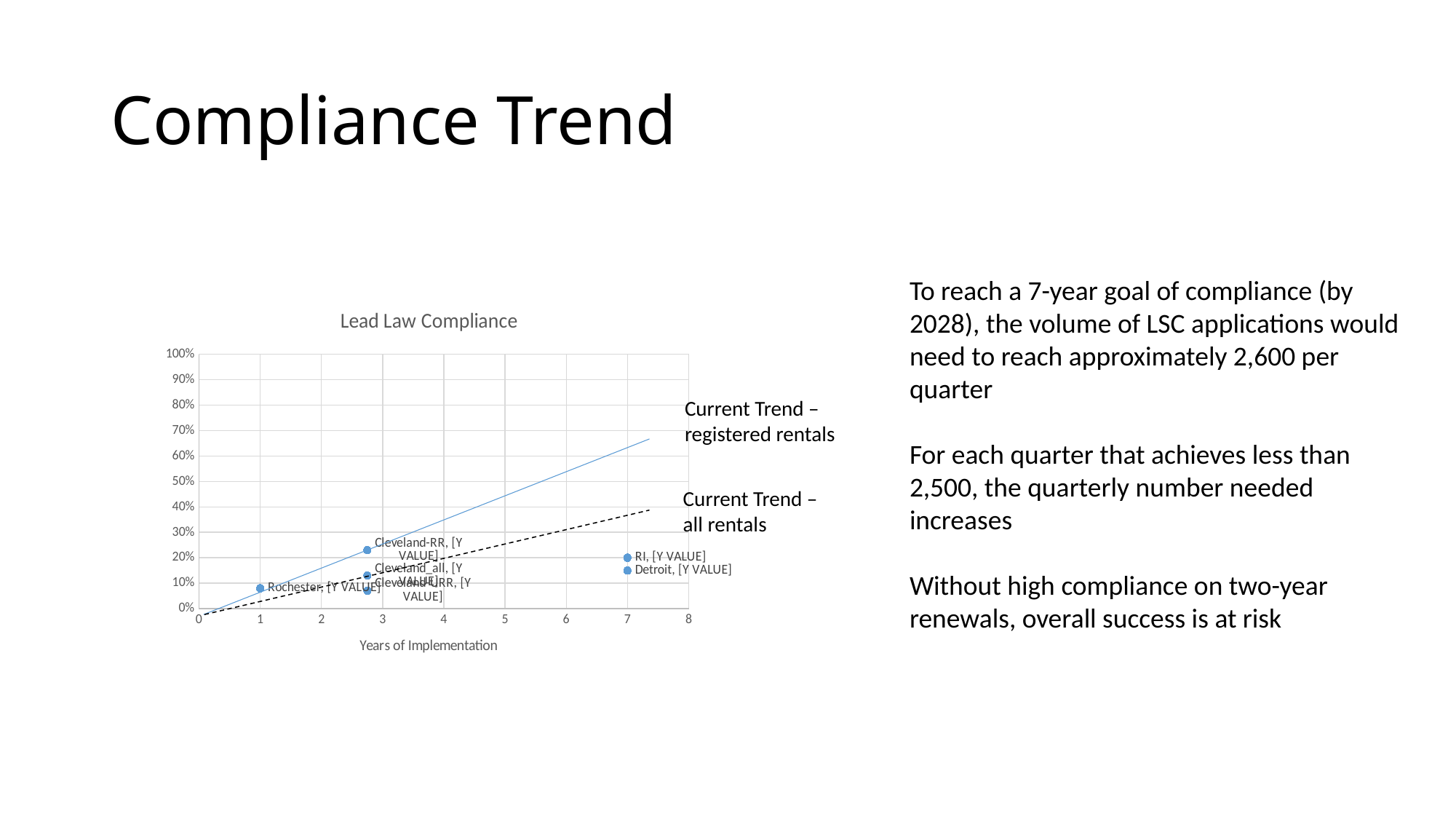
Which trend line is higher at 7 years of implementation, the registered rentals trend or the all rentals trend? registered rentals How many labelled data points are plotted on the chart? 6 Which is larger, the value for Cleveland-RR or the value for Cleveland_all? Cleveland-RR Is the value for Detroit greater or less than 10%? greater Do the two trend lines rise or fall as Years of Implementation increases? rise What is the title of the chart? Lead Law Compliance What kind of chart is the Lead Law Compliance chart? scatter chart Which is larger, the value for RI or the value for Detroit? RI Is the value for Cleveland-RR greater or less than 20%? greater Is the value for RI greater or less than 30%? less What is the label of the x axis? Years of Implementation